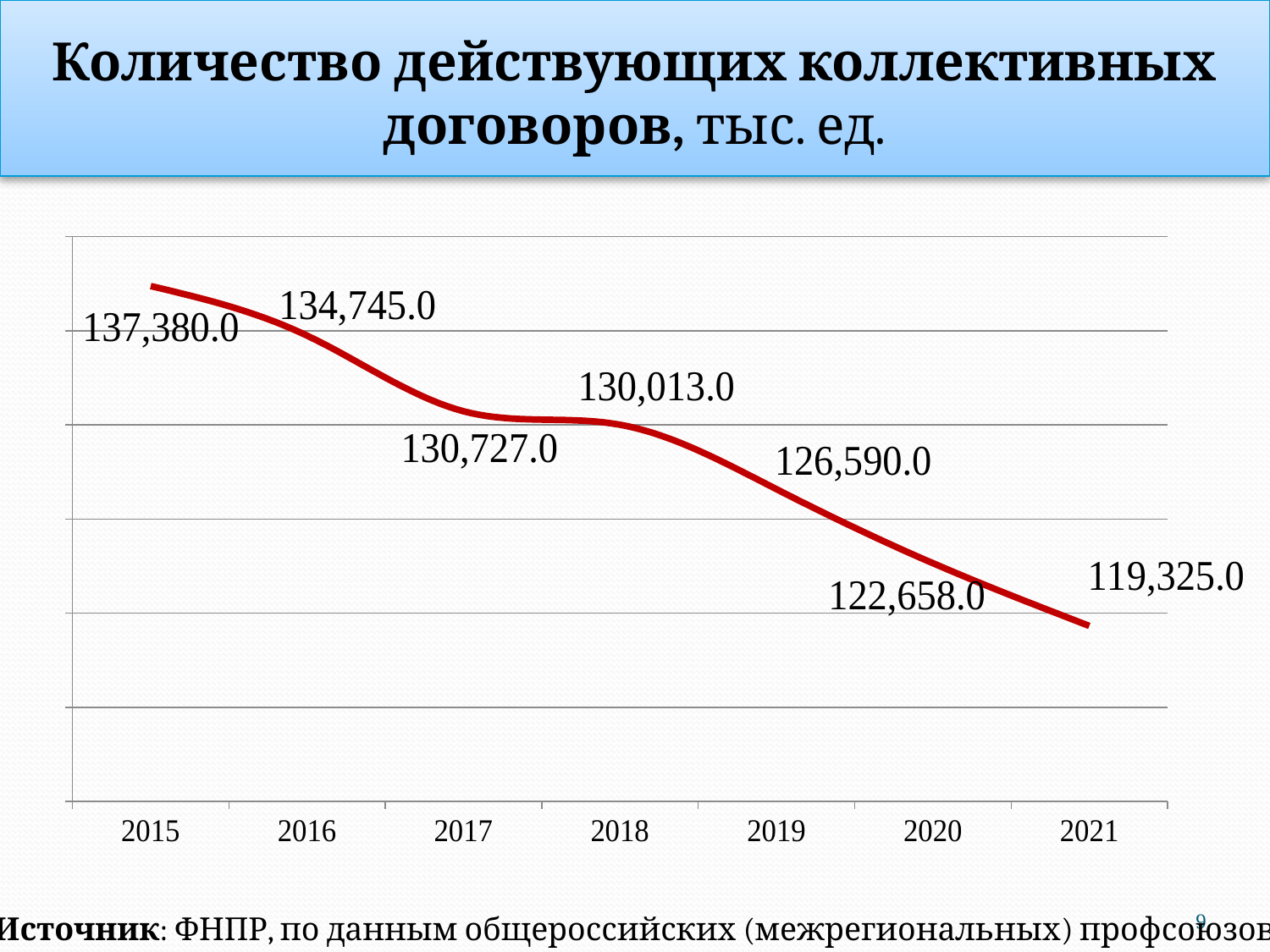
Which year has the highest value? 2015 How many years are plotted on the chart? 7 Do the values rise or fall from 2015 to 2021? fall What is the difference between the values for 2015 and 2021? 18,055.0 Which is larger, the value for 2016 or the value for 2019? 2016 What is the difference between the values for 2019 and 2020? 3,932.0 What is the value for 2018? 130,013.0 What is the value for 2020? 122,658.0 What type of chart is shown on the slide? line chart What is the value for 2015? 137,380.0 Which year has the lowest value? 2021 What is the value for 2021? 119,325.0